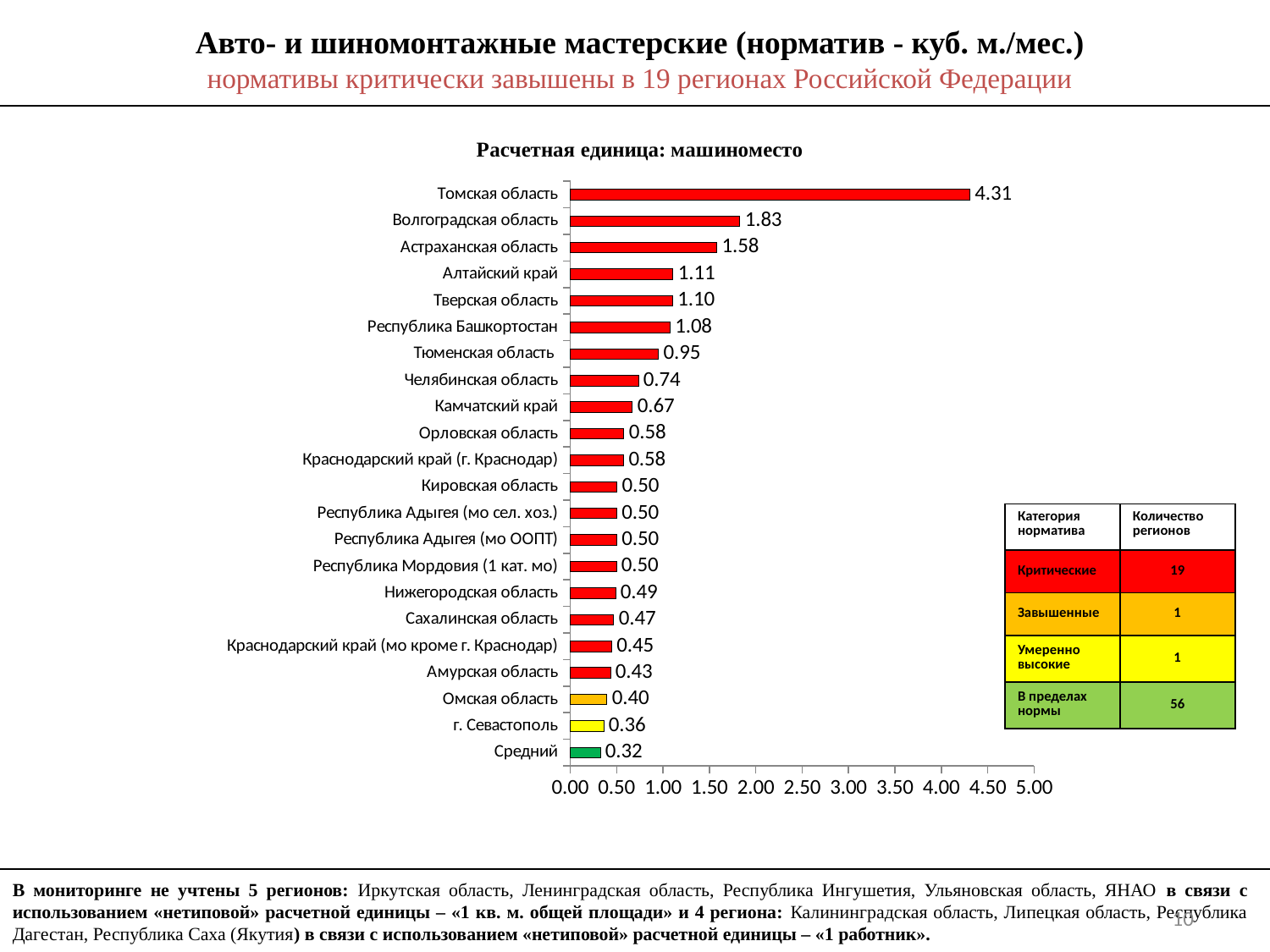
What is the value for Волгоградская область? 1.83 Is the value for Тюменская область greater or less than 1.00? less What is the difference between the values for Томская область and Волгоградская область? 2.48 What is the value for Средний? 0.32 Which has a larger value, Астраханская область or Алтайский край? Астраханская область How many bars are shown on the chart? 22 Which bar has the lowest value on the chart? Средний Which region has the highest value on the chart? Томская область What kind of chart is shown on the slide? bar chart What is the title printed above the chart? Расчетная единица: машиноместо What is the value for Томская область? 4.31 What is the value for Омская область? 0.40